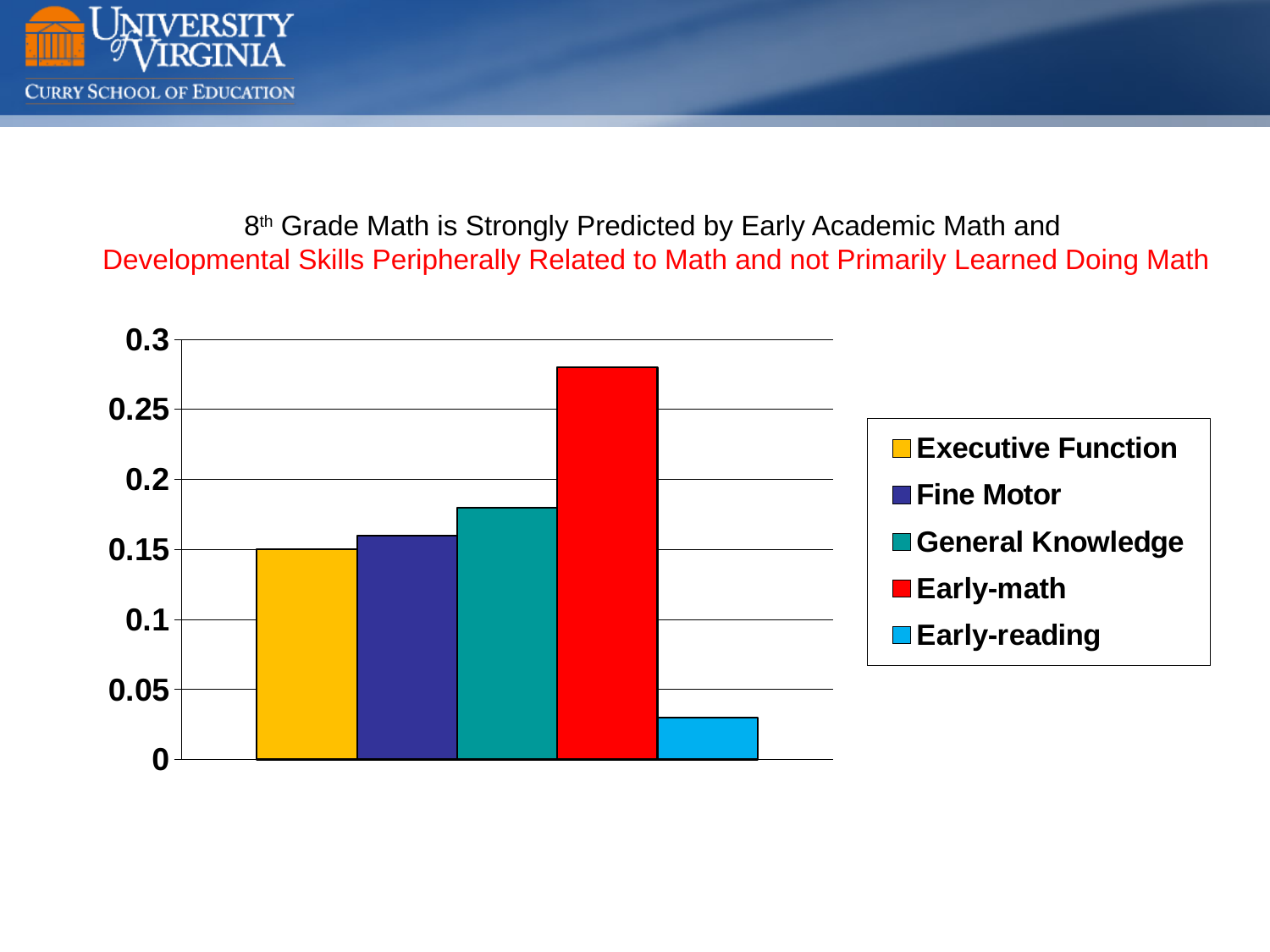
Is the value for General Knowledge greater or less than 0.2? less Is the value for Fine Motor greater or less than 0.15? greater Which series has the highest bar? Early-math What colour is the Early-math bar? red Which is larger, the value for Fine Motor or the value for General Knowledge? General Knowledge Which series has the lowest bar? Early-reading Which is larger, the value for Executive Function or the value for Early-math? Early-math How many bars are plotted in the chart? 5 Is the value for Early-reading greater or less than 0.05? less How many series does the legend list? 5 What kind of chart is shown on the slide? bar chart